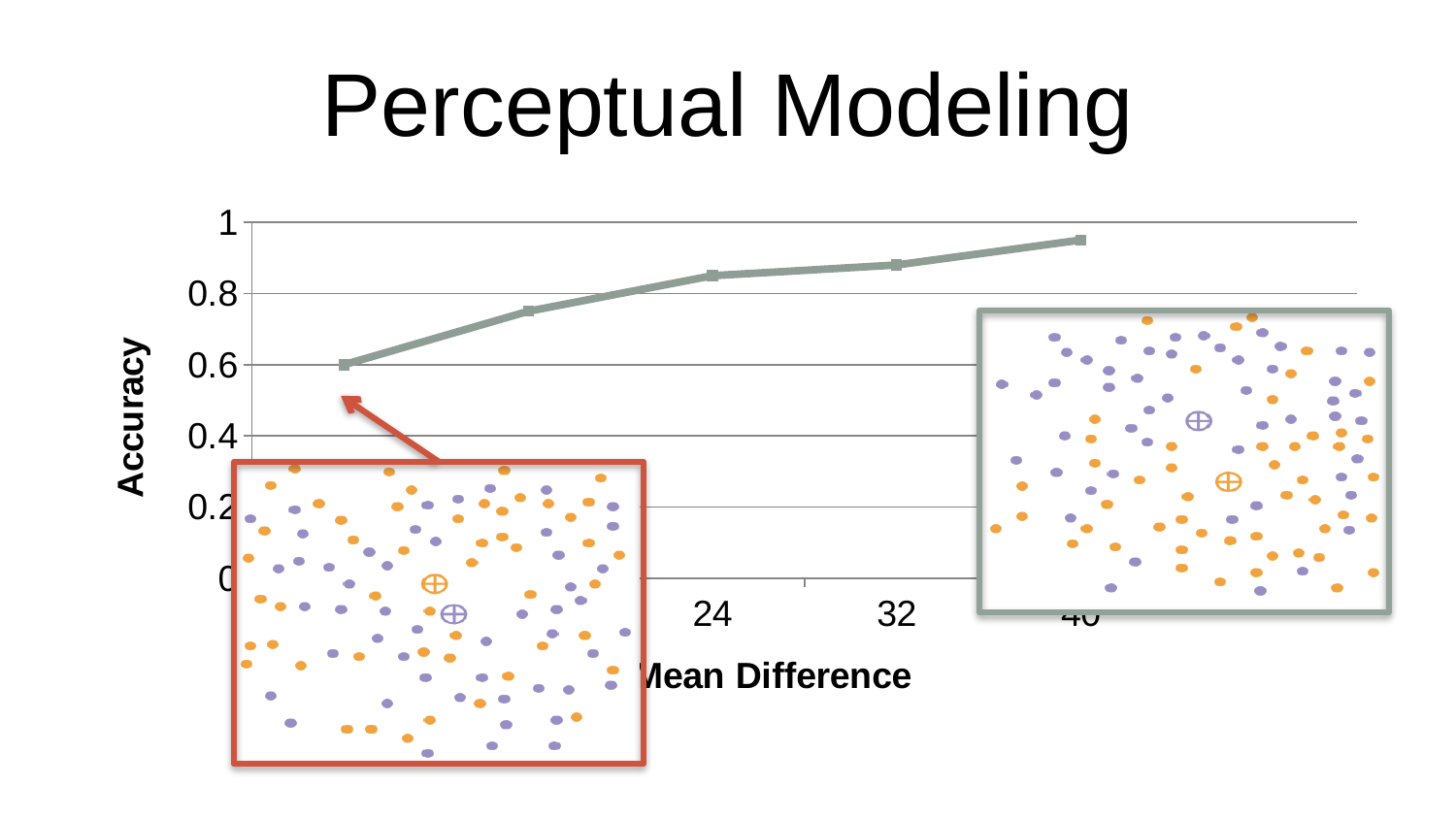
What is the accuracy value of the leftmost point on the line? 0.6 Which Mean Difference value has the highest accuracy? 40 Is the accuracy at a Mean Difference of 40 greater or less than 1? less What is the title of the slide containing the chart? Perceptual Modeling What is the label of the y axis of the chart? Accuracy Which has the higher accuracy, a Mean Difference of 24 or 40? 40 Is the accuracy at a Mean Difference of 24 greater or less than 0.8? greater How many data points are plotted on the line? 5 Is the accuracy of the leftmost point greater or less than 0.8? less What kind of chart is shown on the slide? line chart Does accuracy rise or fall as Mean Difference increases along the x axis? rises